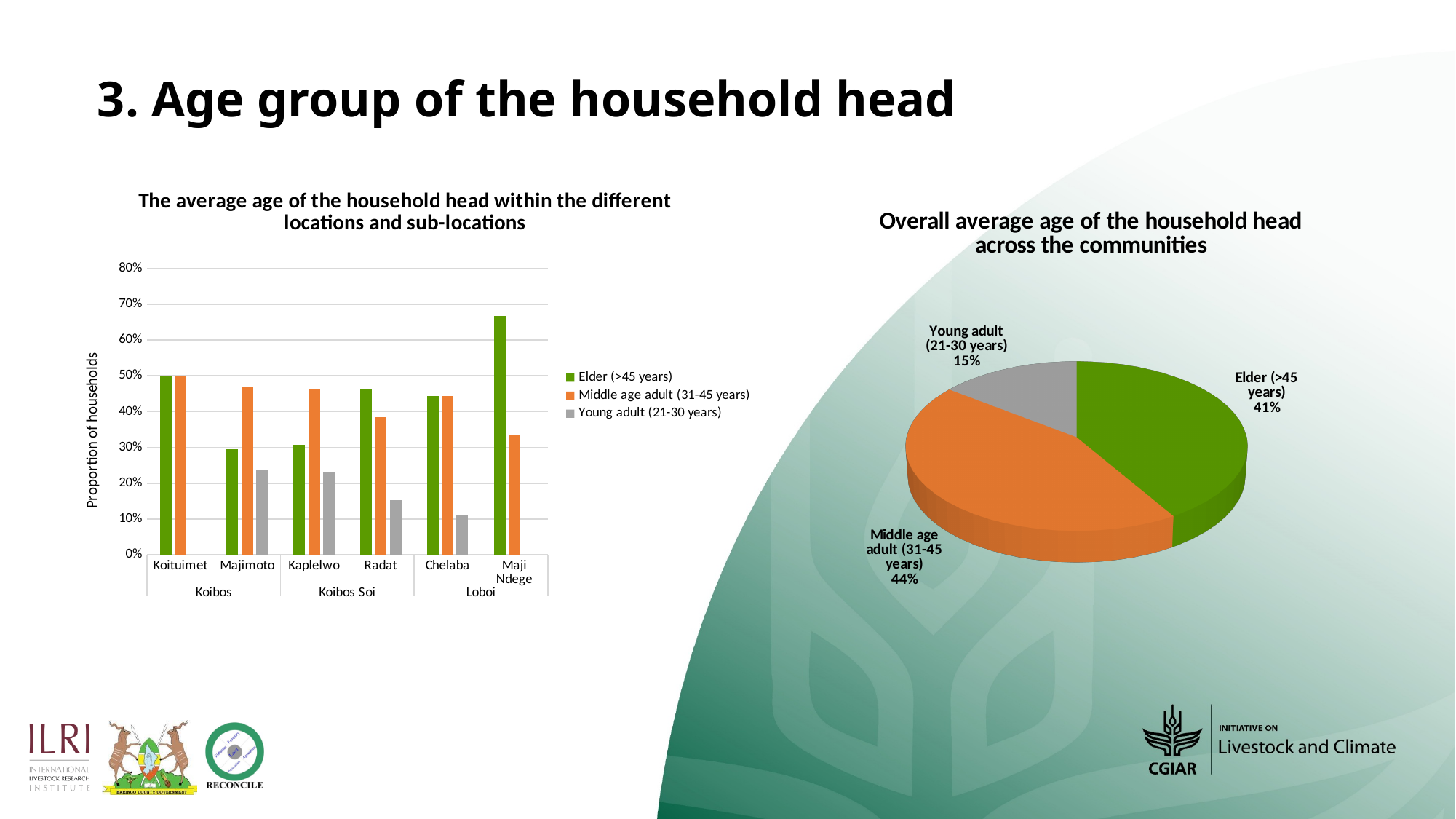
What kind of chart is the chart on the left, 'The average age of the household head within the different locations and sub-locations'? Bar chart In the bar chart on the left, for Majimoto, which is larger: Elder (>45 years) or Middle age adult (31-45 years)? Middle age adult (31-45 years) In the pie chart on the right, what is the difference in percentage points between the Middle age adult and Elder shares? 3% In the bar chart on the left, which sub-location has the highest Elder (>45 years) value? Maji Ndege How many slices does the pie chart on the right have? 3 In the pie chart on the right, which age group has the smallest share? Young adult (21-30 years) In the pie chart 'Overall average age of the household head across the communities', what share is Young adult (21-30 years)? 15% In the pie chart 'Overall average age of the household head across the communities', what share is Middle age adult (31-45 years)? 44% How many series does the legend of the bar chart on the left list? 3 In the pie chart 'Overall average age of the household head across the communities', what share is Elder (>45 years)? 41% In the pie chart on the right, which age group has the largest share? Middle age adult (31-45 years) In the bar chart on the left, is the Elder (>45 years) value for Maji Ndege greater or less than 60%? greater